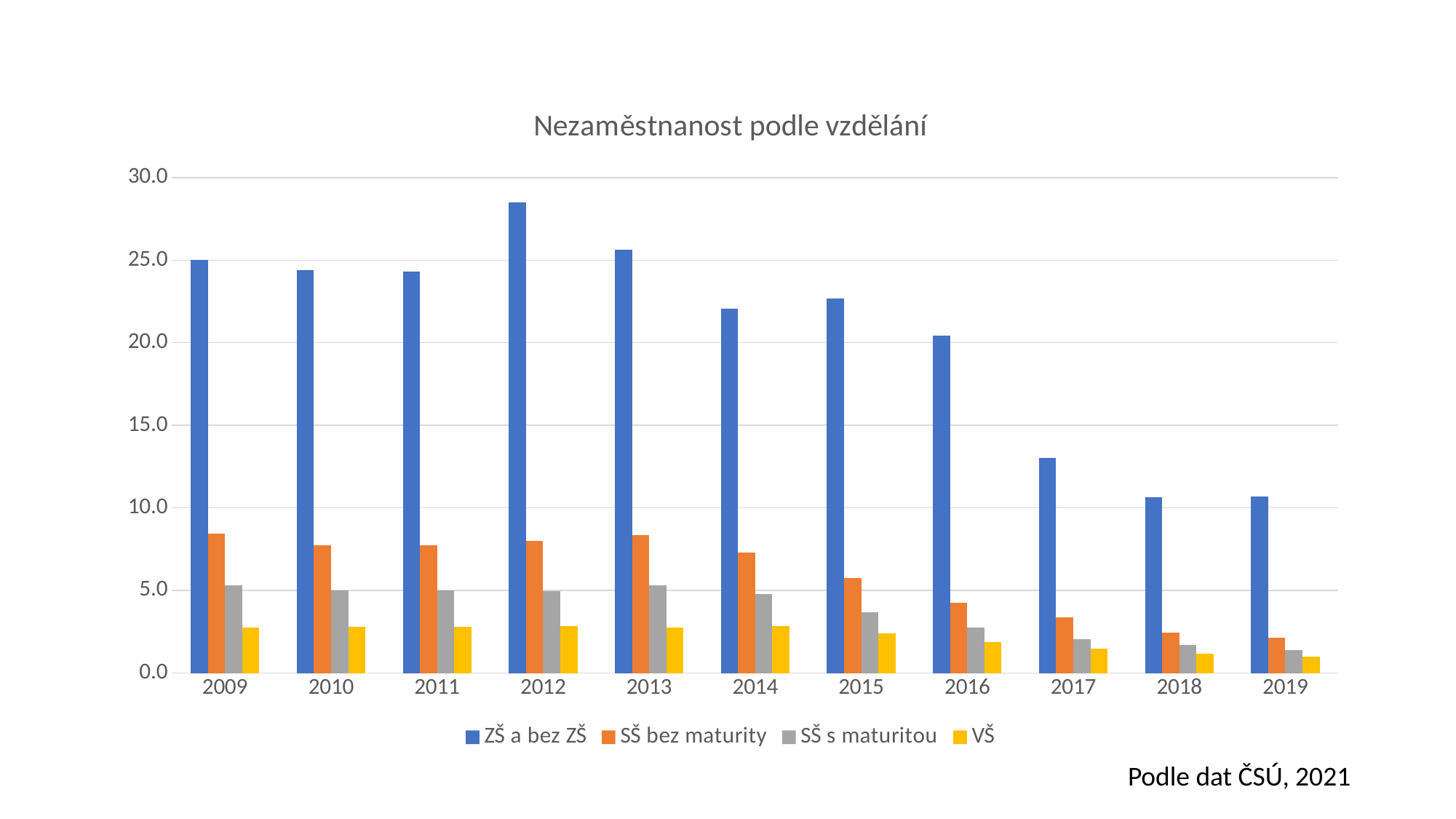
How many years are shown on the x axis? 11 Is the value for SŠ bez maturity in 2009 greater or less than 5.0? greater Which series has the highest value in 2009? ZŠ a bez ZŠ Is the value for ZŠ a bez ZŠ in 2017 greater or less than 15.0? less What kind of chart is shown on the slide? bar chart What is the title of the chart? Nezaměstnanost podle vzdělání Is the value for ZŠ a bez ZŠ in 2012 greater or less than 25.0? greater Do the values for ZŠ a bez ZŠ rise or fall from 2013 to 2019? fall Which series has the lowest value in 2019? VŠ How many series does the legend list? 4 Which is larger: the value for ZŠ a bez ZŠ in 2009 or in 2014? 2009 In which year is the value for ZŠ a bez ZŠ the highest? 2012